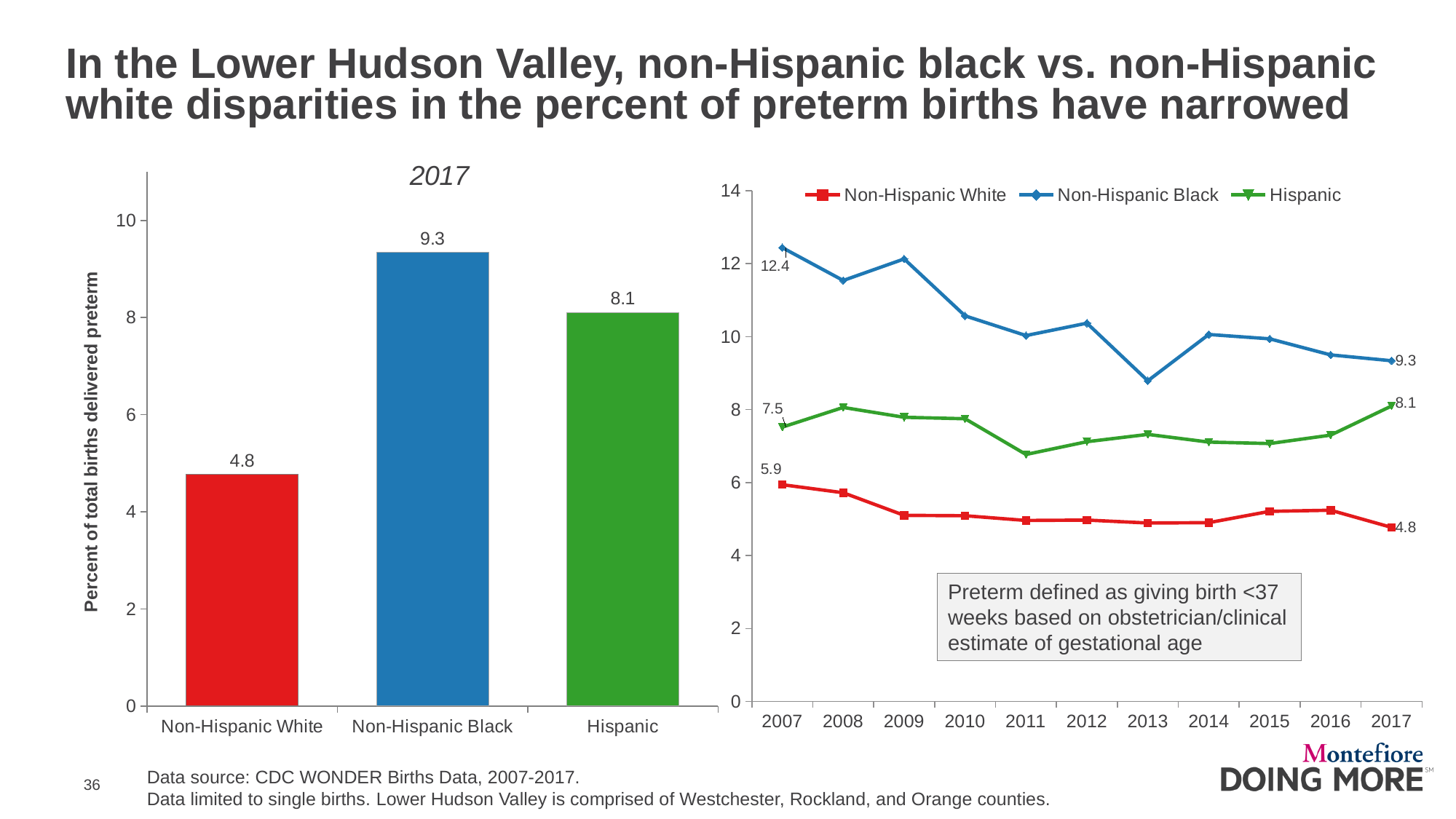
In the line chart on the right, what was the Hispanic value in 2007? 7.5 In the line chart on the right, is the Non-Hispanic Black value for 2013 greater or less than 10? less In the line chart on the right, did the Non-Hispanic Black values rise or fall from 2007 to 2017? Fall In the line chart on the right, what was the Non-Hispanic Black value in 2007? 12.4 In the line chart on the right, how many series does the legend list? 3 In the 2017 bar chart on the left, what is the percent of total births delivered preterm for Non-Hispanic Black? 9.3 In the 2017 bar chart on the left, which group has the lowest percent of preterm births? Non-Hispanic White In the 2017 bar chart on the left, how many groups are shown? 3 What kind of chart is the chart on the left? Bar chart In the 2017 bar chart on the left, which group has the highest percent of preterm births? Non-Hispanic Black In the 2017 bar chart on the left, what is the difference between the Non-Hispanic Black and Non-Hispanic White values? 4.5 In the 2017 bar chart on the left, what is the value for Non-Hispanic White? 4.8